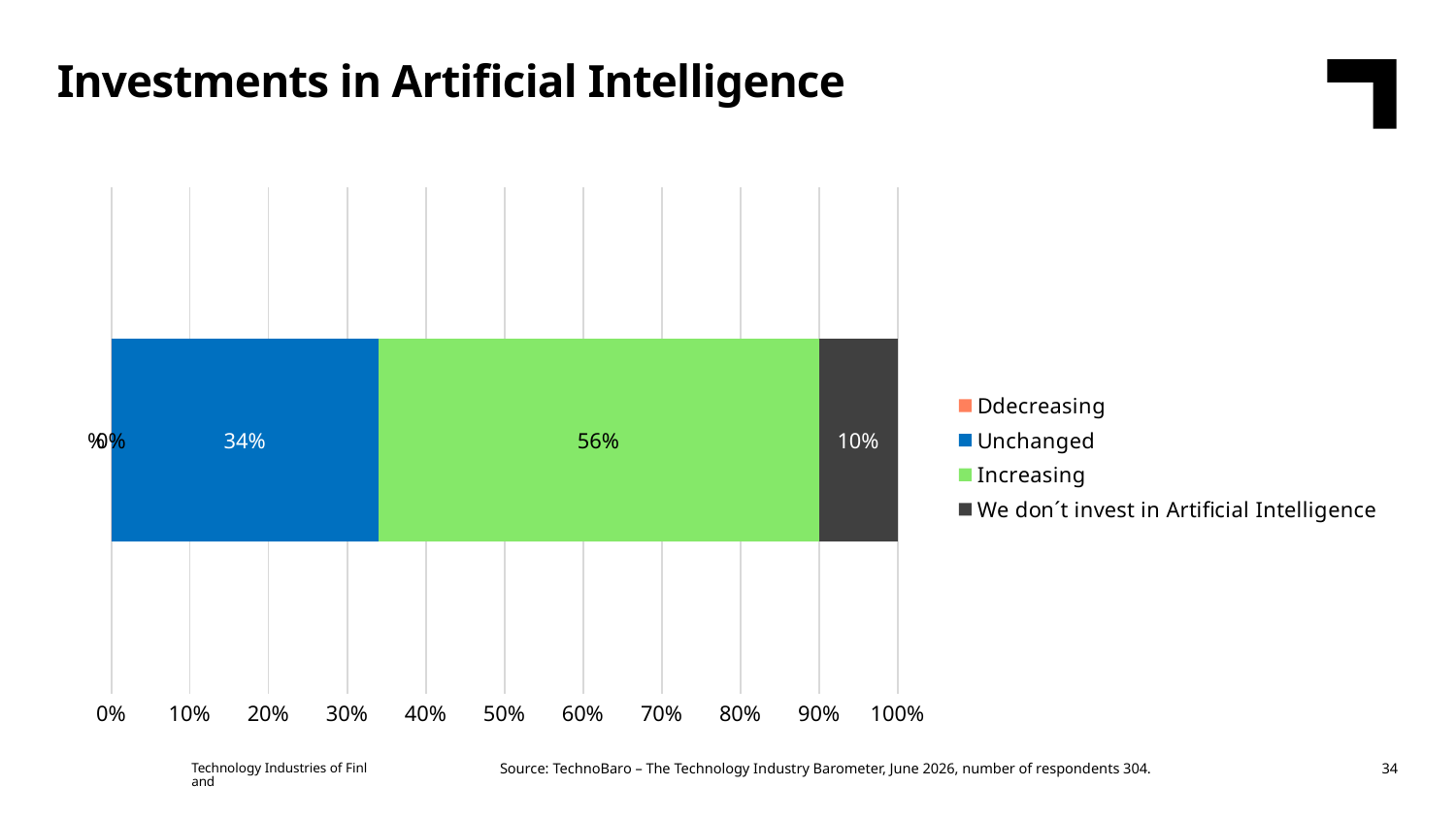
What is the title of the slide? Investments in Artificial Intelligence How many series does the legend list? 4 Is the value for 'Increasing' greater or less than 50%? greater What kind of chart is shown on the slide? Stacked bar chart Which is larger, the 'Unchanged' segment or the 'We don't invest in Artificial Intelligence' segment? Unchanged What percentage of respondents report their investments in Artificial Intelligence are unchanged? 34% What colour represents the 'Increasing' category in the chart? Green How many percentage points larger is the 'Increasing' segment than the 'Unchanged' segment? 22% What is the value shown for the 'Increasing' segment? 56% Which legend category has the largest segment in the bar? Increasing What is the total of the 'Unchanged', 'Increasing' and 'We don't invest in Artificial Intelligence' segments? 100% What share of respondents say 'We don't invest in Artificial Intelligence'? 10%